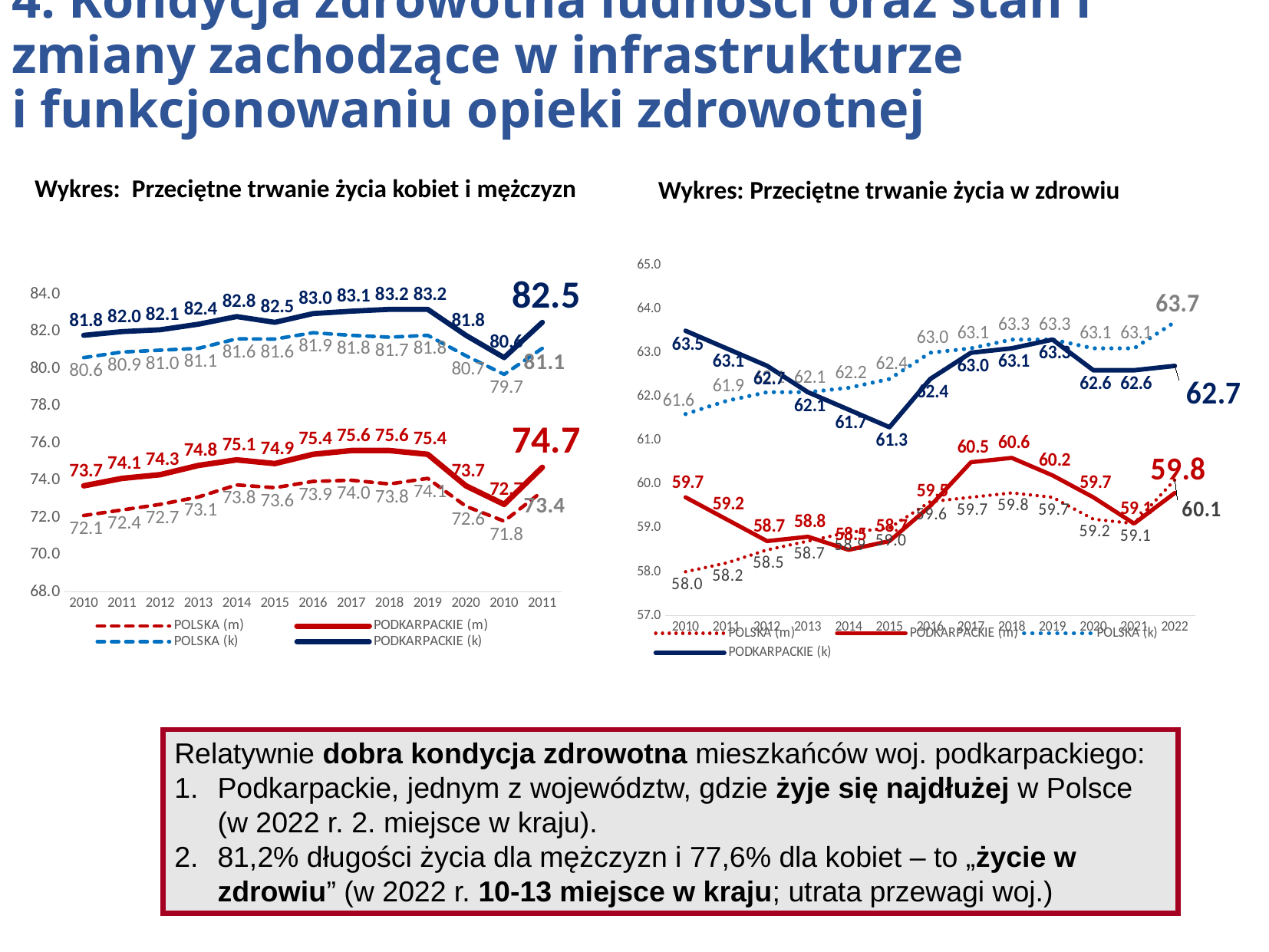
In the chart 'Przeciętne trwanie życia w zdrowiu', what is the value for PODKARPACKIE (k) in 2015? 61.3 In the chart 'Przeciętne trwanie życia w zdrowiu', in which year does PODKARPACKIE (m) reach its highest value? 2018 What type of chart is 'Przeciętne trwanie życia kobiet i mężczyzn'? Line chart In the chart 'Przeciętne trwanie życia kobiet i mężczyzn', what is the value for PODKARPACKIE (k) in 2019? 83.2 In the chart 'Przeciętne trwanie życia kobiet i mężczyzn', what is the value for POLSKA (m) in 2015? 73.6 In the chart 'Przeciętne trwanie życia w zdrowiu', which is larger in 2022: PODKARPACKIE (m) or POLSKA (m)? POLSKA (m) In the chart 'Przeciętne trwanie życia kobiet i mężczyzn', what is the value for PODKARPACKIE (m) in 2017? 75.6 In the chart 'Przeciętne trwanie życia kobiet i mężczyzn', how many series does the legend list? 4 In the chart 'Przeciętne trwanie życia w zdrowiu', what is the difference between PODKARPACKIE (m) and POLSKA (m) in 2010? 1.7 In the chart 'Przeciętne trwanie życia w zdrowiu', what is the value for POLSKA (k) in 2022? 63.7 In the chart 'Przeciętne trwanie życia w zdrowiu', how many years are shown on the x axis? 13